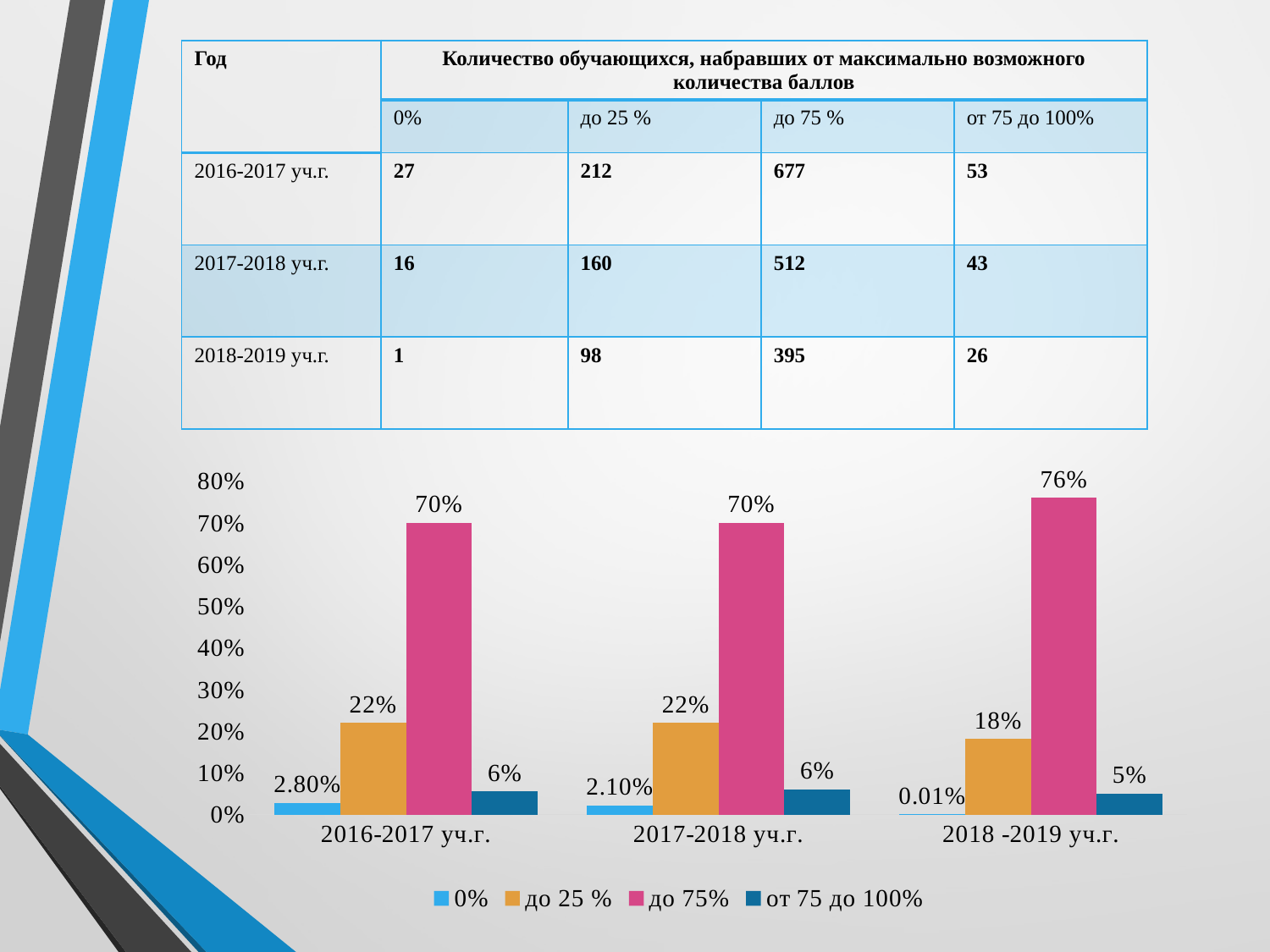
How many year categories are shown on the x axis of the chart? 3 How many series does the chart legend list? 4 Which year has the lowest value for the "0%" series? 2018 -2019 уч.г. What is the value of the "до 75%" series for 2018 -2019 уч.г.? 76% What is the value of the "до 25 %" series for 2018 -2019 уч.г.? 18% Which is larger for 2018 -2019 уч.г.: the "до 25 %" value or the "от 75 до 100%" value? до 25 % What is the value of the "0%" series for 2016-2017 уч.г.? 2.80% Is the "до 75%" value for 2017-2018 уч.г. greater or less than 60%? greater Which year has the highest value for the "до 75%" series? 2018 -2019 уч.г. What is the difference between the "до 75%" values for 2018 -2019 уч.г. and 2016-2017 уч.г.? 6% What kind of chart is shown on the slide? bar chart What is the value of the "от 75 до 100%" series for 2017-2018 уч.г.? 6%